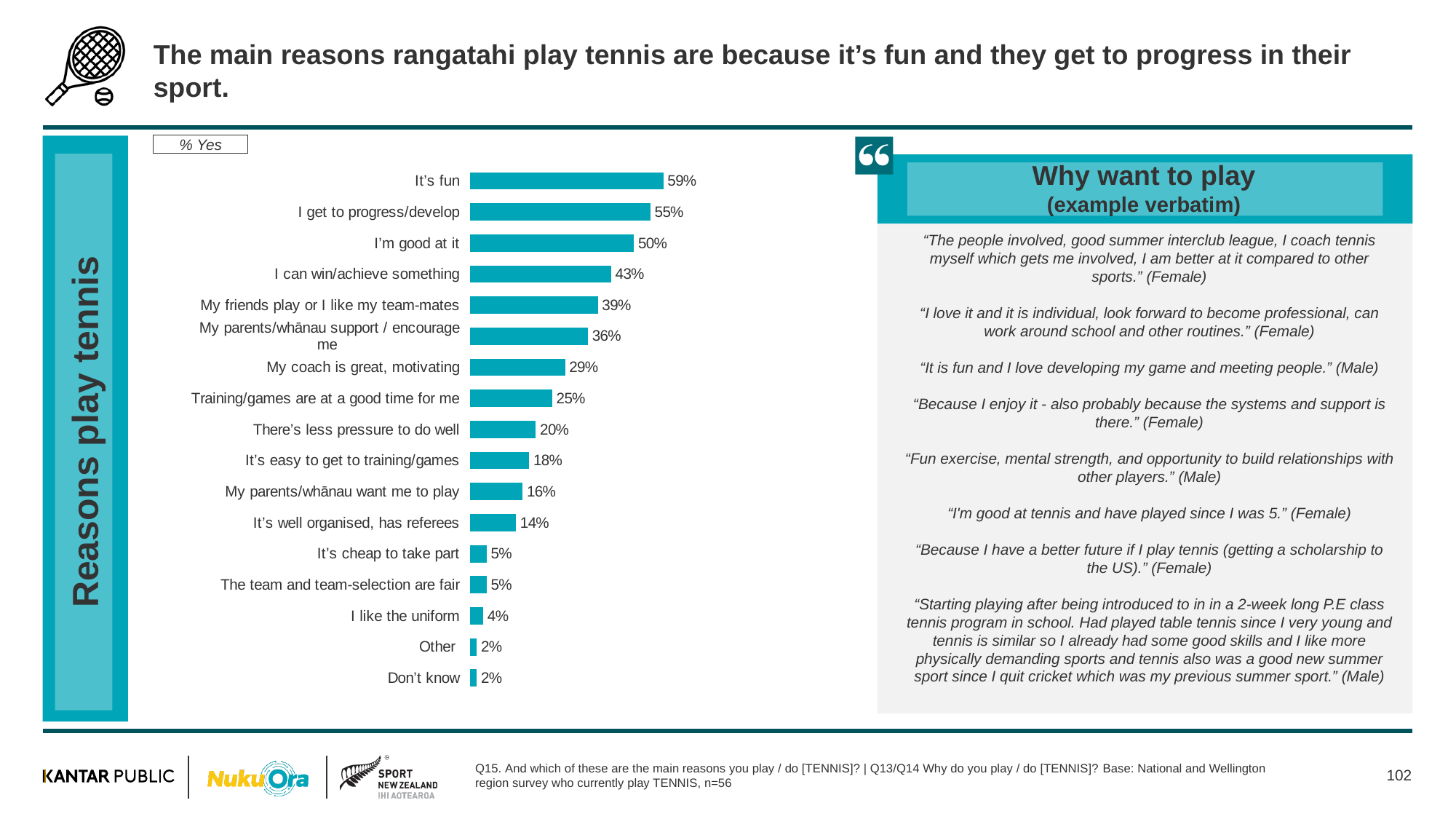
What percentage of rangatahi say they play tennis because it's fun? 59% What is the difference between "I'm good at it" and "There's less pressure to do well"? 30% What is the value for "My coach is great, motivating"? 29% Do the values rise or fall going down the list of reasons from top to bottom? Fall How many reasons (categories) are shown in the chart? 17 What is the difference between "It's fun" and "I get to progress/develop"? 4% What kind of chart is used to show the reasons rangatahi play tennis? Bar chart What is the value for "It's well organised, has referees"? 14% Which reason has the highest percentage? It's fun Which is larger: "My friends play or I like my team-mates" or "My parents/whānau support / encourage me"? My friends play or I like my team-mates Which is larger: "It's easy to get to training/games" or "My parents/whānau want me to play"? It's easy to get to training/games What unit label is shown above the chart? % Yes